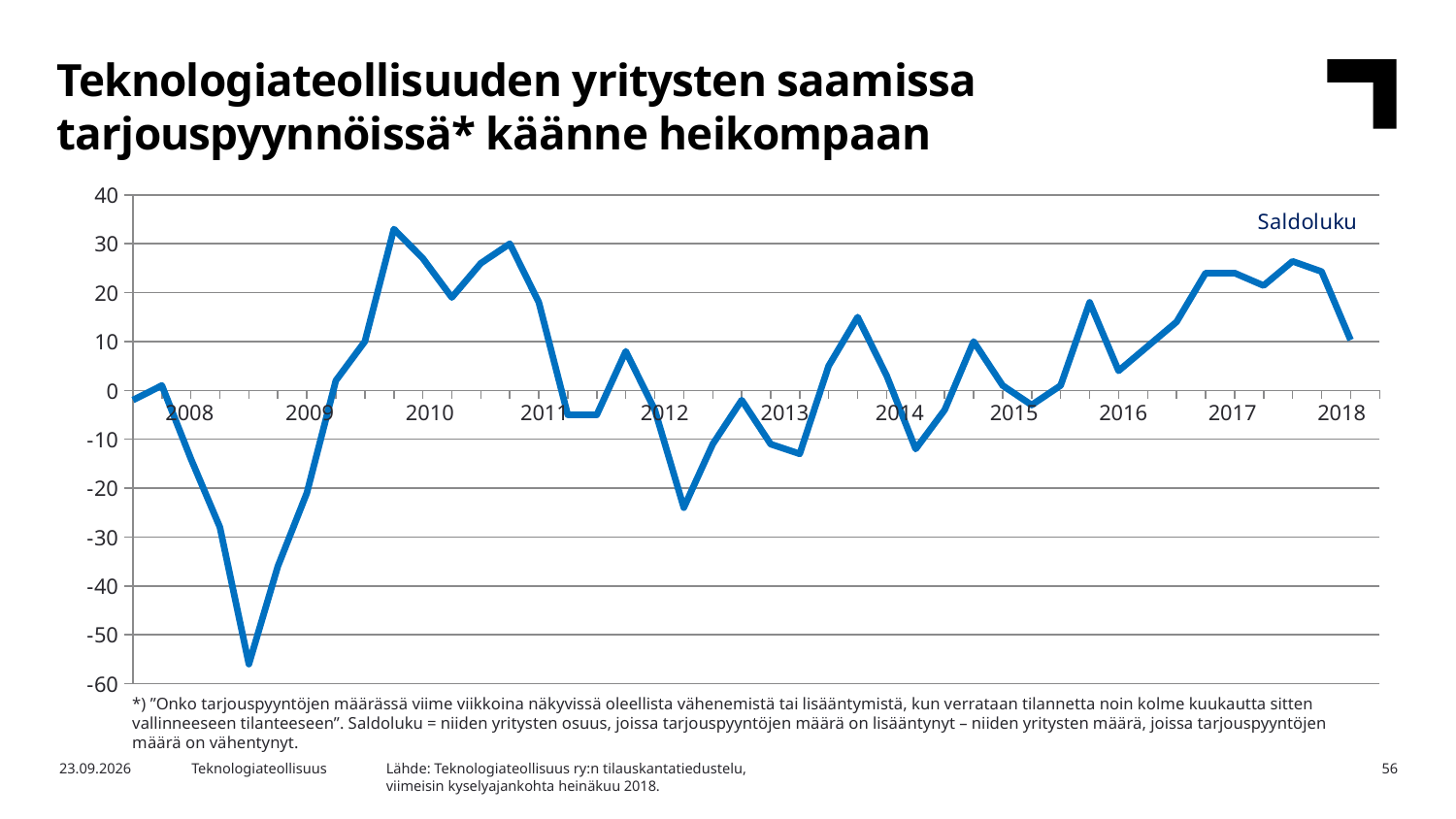
Is the lowest point of the line greater or less than -50? less Is the value at the 2012 tick greater or less than 0? less How many year labels are shown on the x axis? 11 What is the name of the series plotted on the chart? Saldoluku What is the highest value shown on the y axis? 40 Does the line rise or fall between the 2008 tick and the 2009 tick? fall What kind of chart is shown on the slide? line chart Does the line rise or fall between the 2017 tick and the 2018 tick? fall Is the highest point of the line greater or less than 30? greater